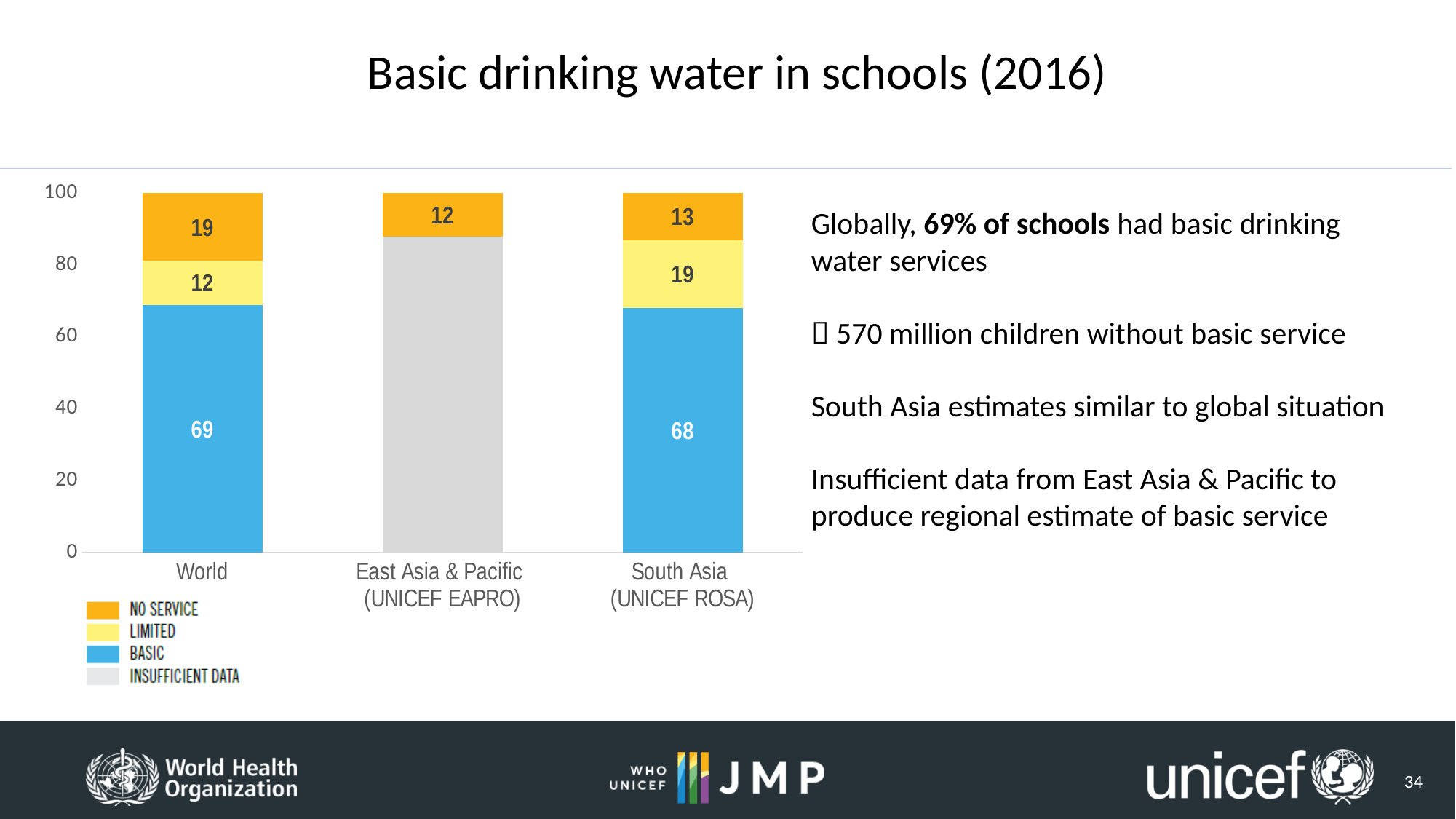
Which category has the highest No Service value? World What kind of chart is shown on the slide? Stacked bar chart Which category has the lowest No Service value? East Asia & Pacific (UNICEF EAPRO) What is the Basic value for South Asia (UNICEF ROSA)? 68 Is the No Service value larger for World or for South Asia (UNICEF ROSA)? World What is the No Service value for East Asia & Pacific (UNICEF EAPRO)? 12 What is the Limited value for South Asia (UNICEF ROSA)? 19 What is the Basic value for World? 69 How many categories are shown on the x axis? 3 How many series does the legend list? 4 Is the Insufficient Data value for East Asia & Pacific (UNICEF EAPRO) greater or less than 80? greater What is the difference between the Limited value for South Asia (UNICEF ROSA) and the Limited value for World? 7